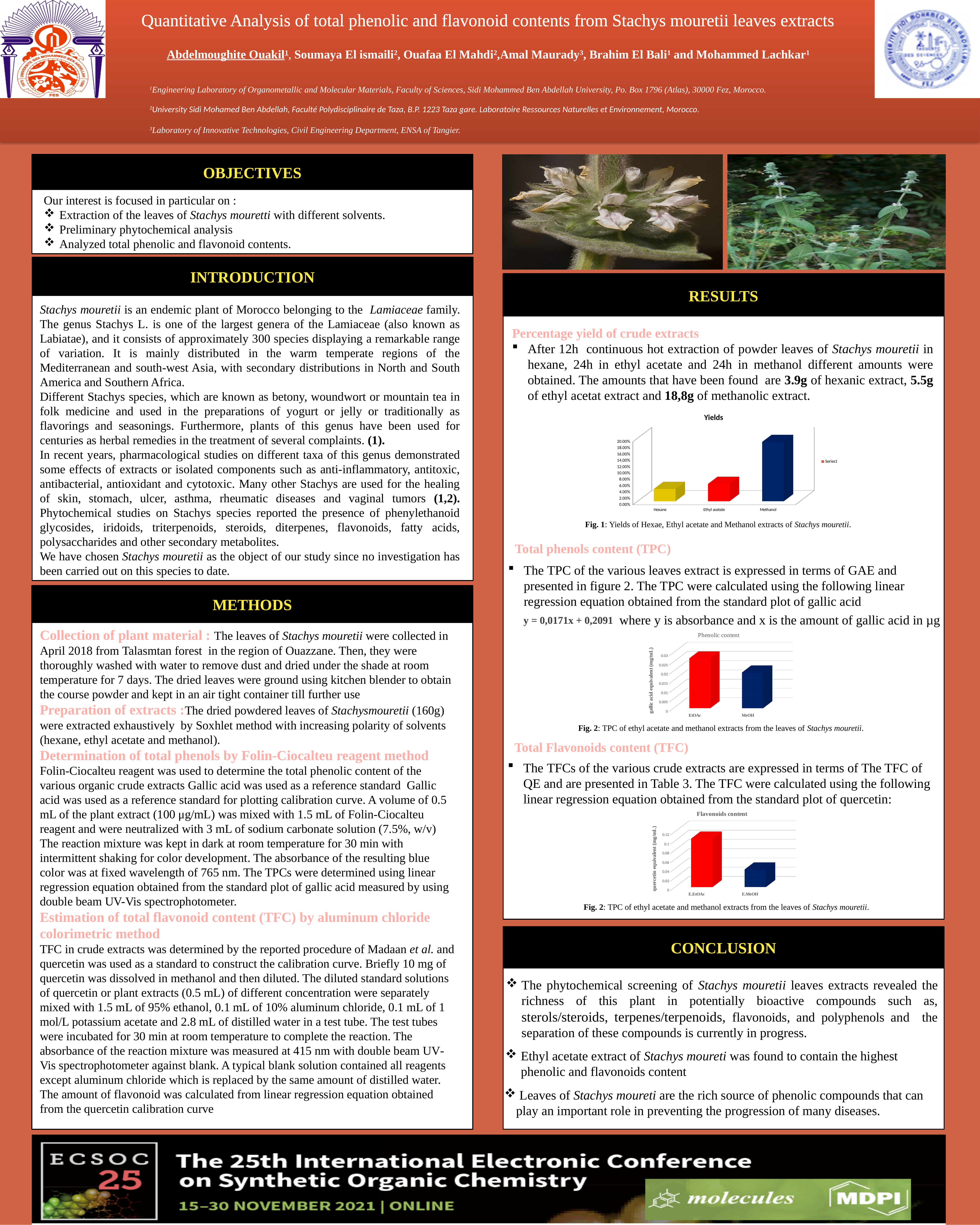
How many series does the legend of the Yields chart list? 1 How many categories are plotted in the Yields chart? 3 What kind of chart is the Yields chart? bar chart What is the y-axis label of the Flavonoids content chart? quercetin equivalent (mg/mL) In the Yields chart, is the value for Methanol greater or less than 10.00%? greater In the Flavonoids content chart, which category has the highest value? E.EtOAc In the Phenolic content chart, which category has the higher value, EtOAc or MeOH? EtOAc In the Flavonoids content chart, is the value for E.MeOH greater or less than 0.06? less In the Yields chart, which category has the lowest value? Hexane In the Yields chart, is the value for Hexane greater or less than 10.00%? less In the Yields chart, which category has the highest value? Methanol